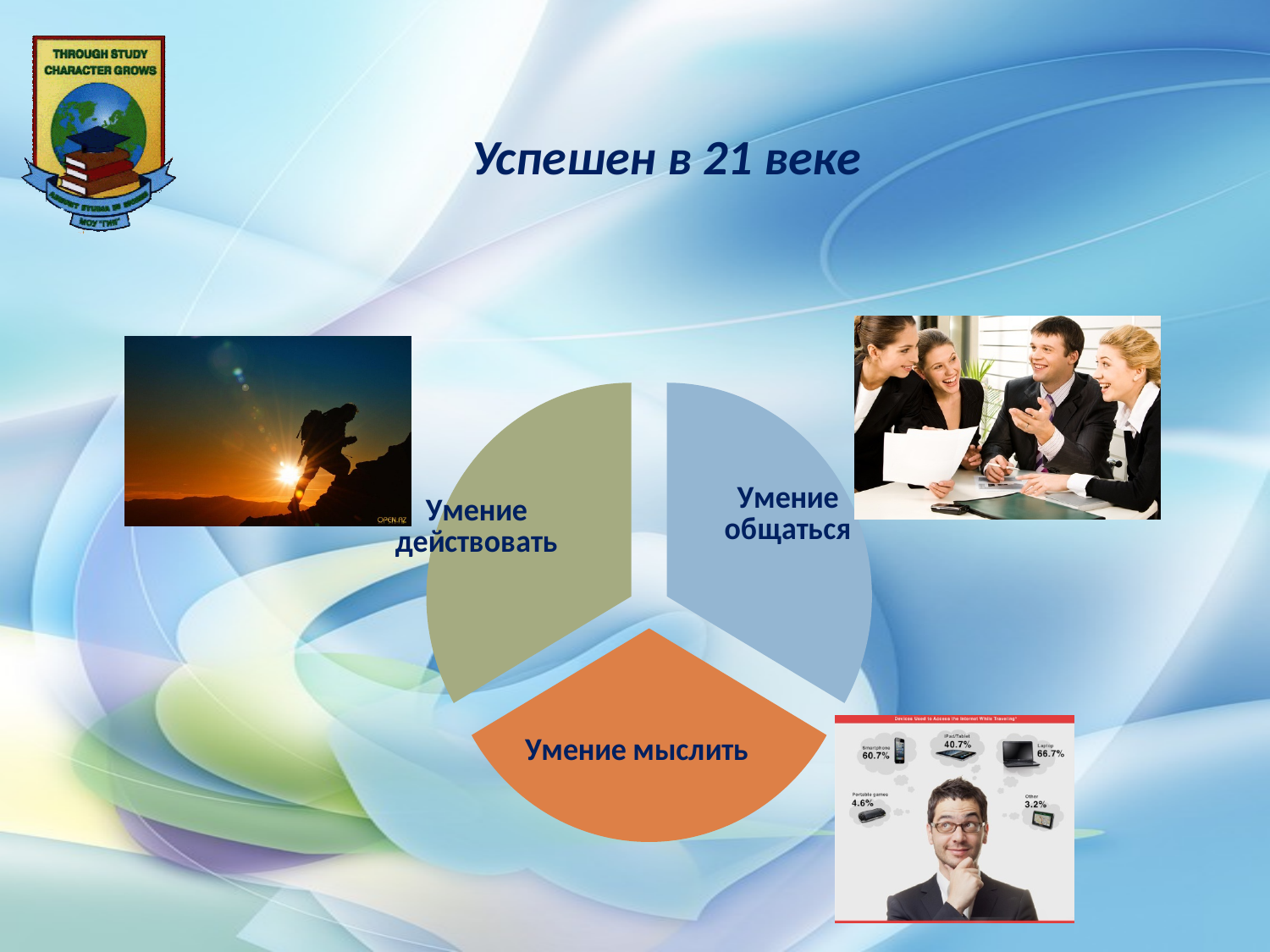
In the infographic image in the bottom right, what percentage is shown for iPad/Tablet? 40.7% In the infographic image in the bottom right, what percentage is shown for Laptop? 66.7% In the infographic image in the bottom right, which is larger, the percentage for Smartphone or for iPad/Tablet? Smartphone In the infographic image in the bottom right, what is the difference between the Laptop and Smartphone percentages? 6.0% In the infographic image in the bottom right, what percentage is shown for Smartphone? 60.7% In the infographic image in the bottom right, which device has the highest percentage? Laptop How many segments does the pie diagram in the centre of the slide have? 3 In the infographic image in the bottom right, which category has the lowest percentage? Other What is the label of the blue segment of the pie diagram? Умение общаться What kind of chart is the three-segment diagram in the centre of the slide? pie chart What is the label of the orange segment of the pie diagram? Умение мыслить In the infographic image in the bottom right, what percentage is shown for Other? 3.2%